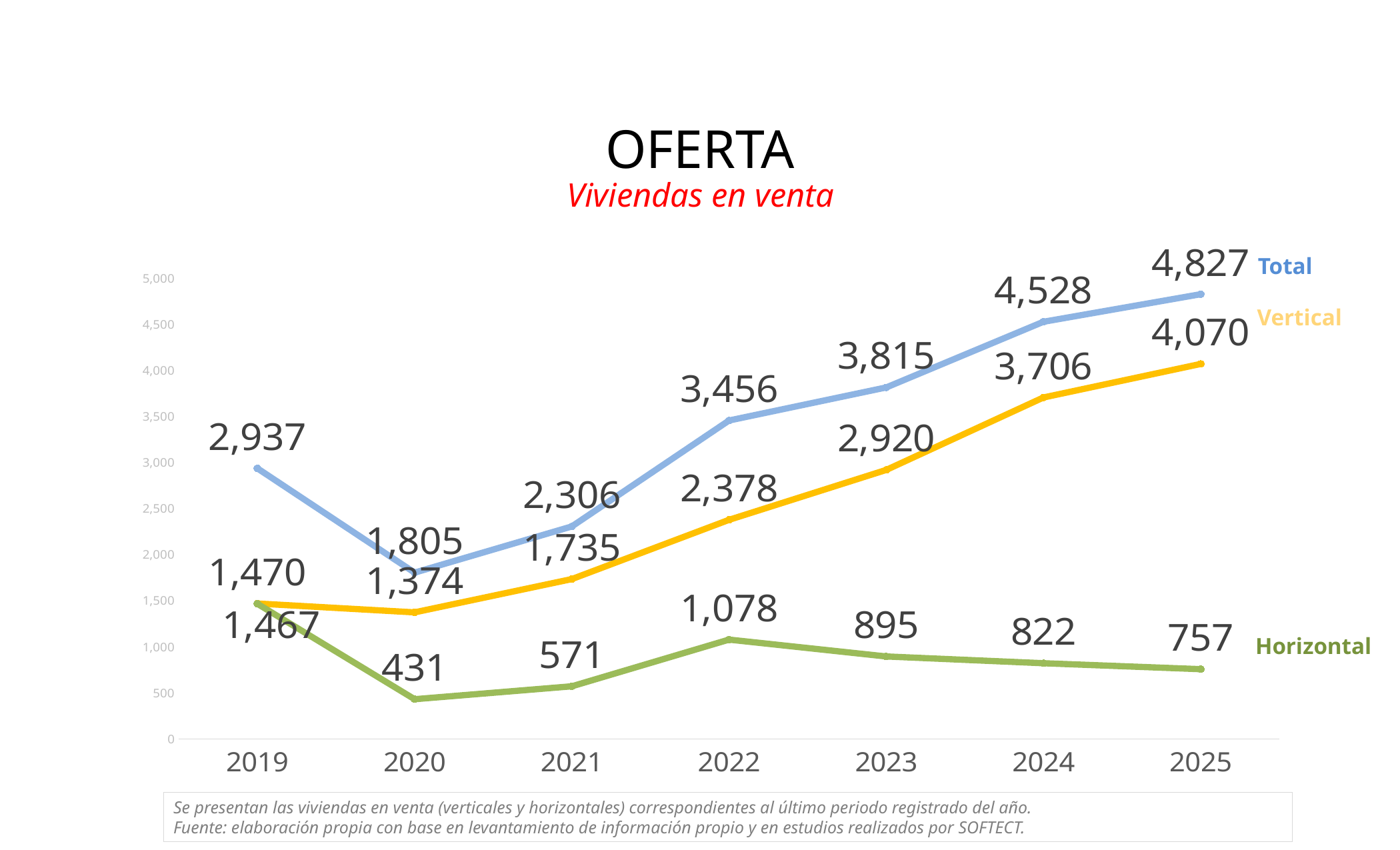
How many years are shown on the x axis? 7 In which year is the Horizontal series at its highest? 2019 What kind of chart is shown on the slide? Line chart Does the Vertical series rise or fall from 2020 to 2025? Rise What is the difference between the Total values for 2025 and 2024? 299 How many series does the chart show? 3 What is the Horizontal value for 2020? 431 What is the Vertical value for 2024? 3,706 Which is larger in 2019: the Vertical value or the Horizontal value? Vertical In which year is the Total series at its lowest? 2020 What is the Total value for 2022? 3,456 Is the Vertical value for 2023 greater or less than 2,500? greater